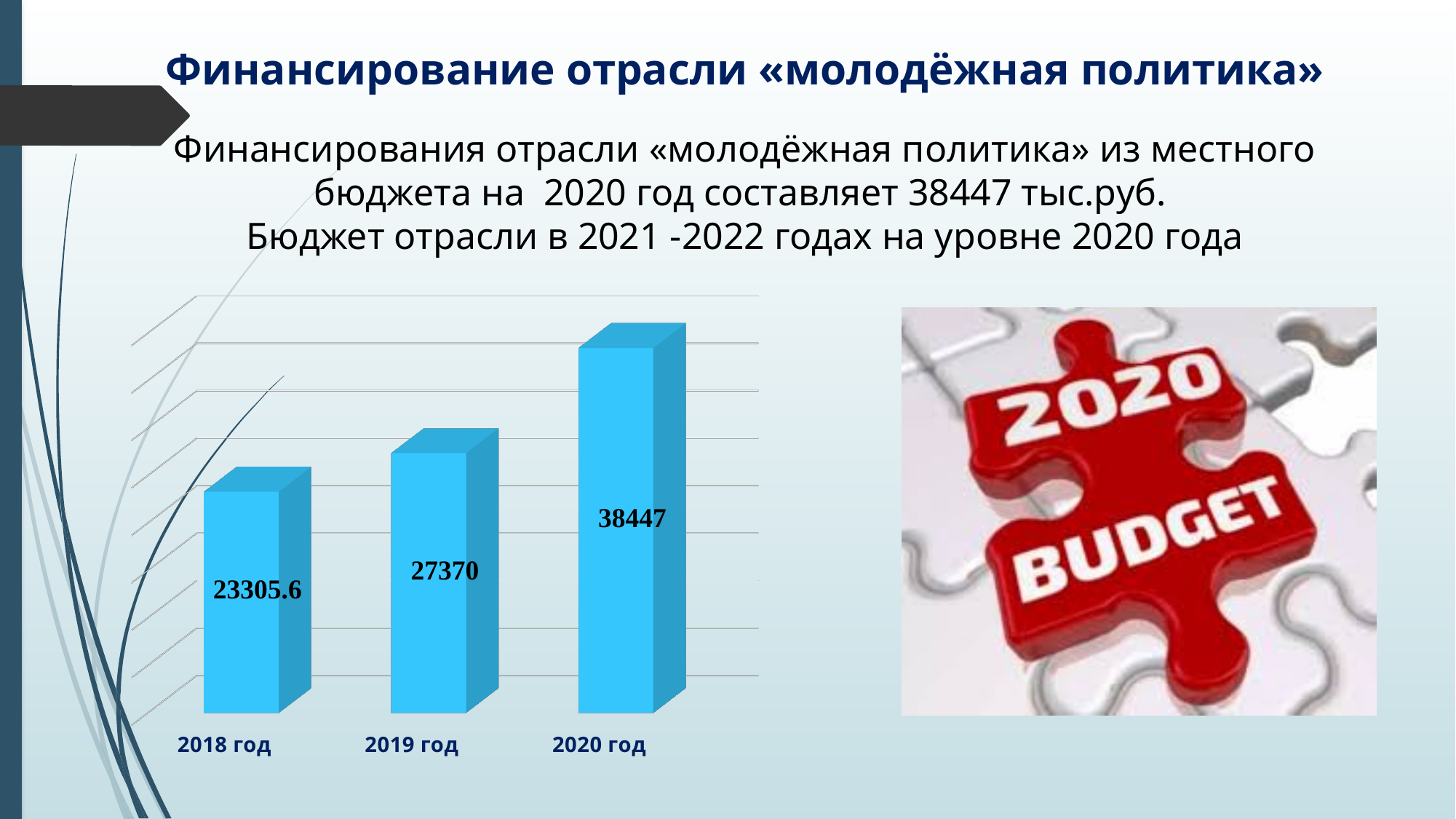
How many categories are shown on the chart? 3 What is the difference between the values for 2019 год and 2018 год? 4064.4 What is the value for 2019 год? 27370 Which is larger, the value for 2019 год or the value for 2018 год? 2019 год What is the value for 2018 год? 23305.6 What is the value for 2020 год? 38447 What is the difference between the values for 2020 год and 2018 год? 15141.4 Do the values rise or fall from 2018 год to 2020 год? rise Which year has the highest value? 2020 год What is the difference between the values for 2020 год and 2019 год? 11077 Which year has the lowest value? 2018 год What kind of chart is shown on the slide? bar chart